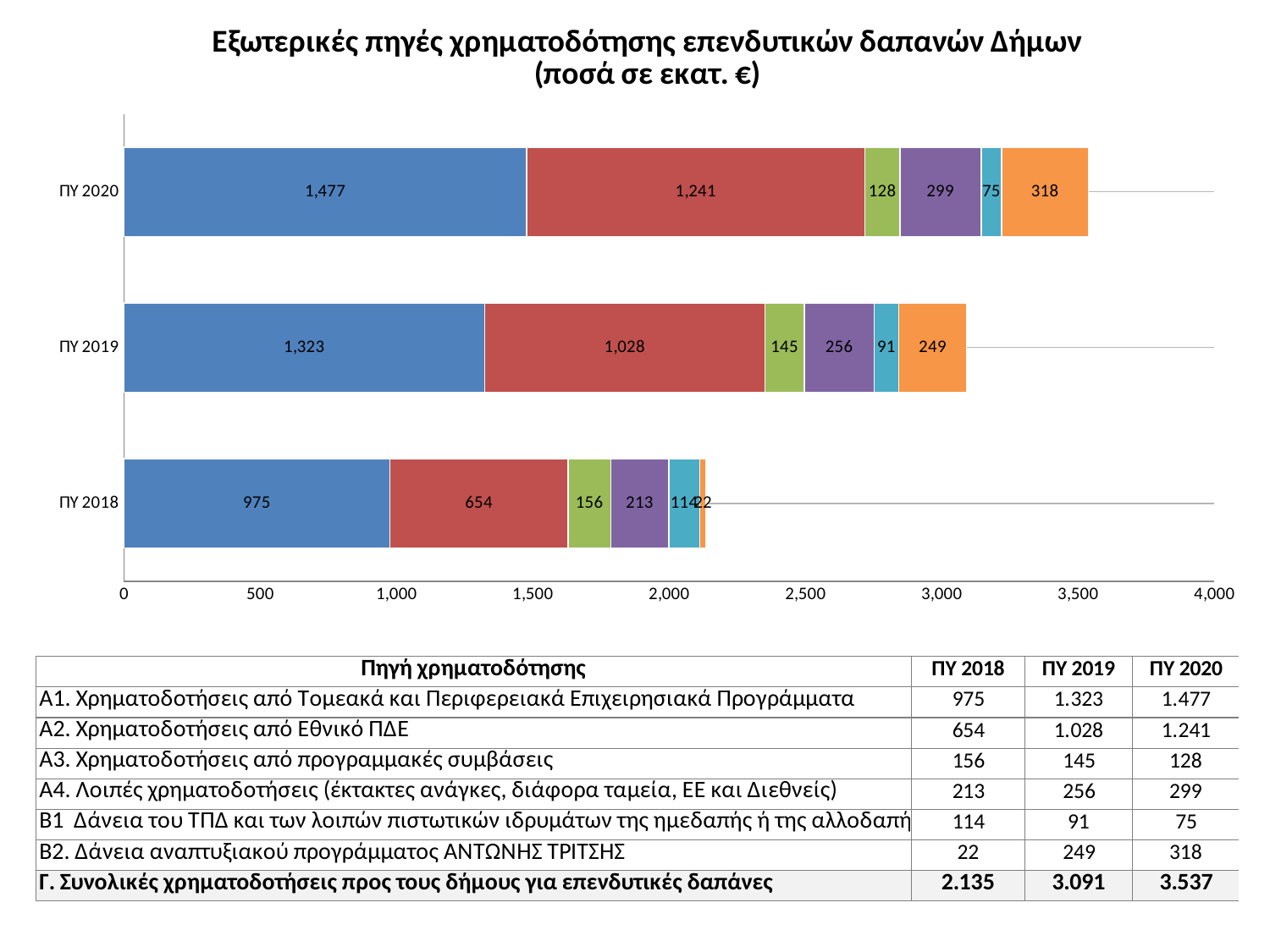
What kind of chart is shown on the slide? Stacked bar chart What is the value of the orange segment of the ΠΥ 2020 bar? 318 What is the value of the second (red) segment of the ΠΥ 2019 bar? 1,028 What is the value of the purple segment of the ΠΥ 2018 bar? 213 Does the value of the first (blue) segment rise or fall from ΠΥ 2018 to ΠΥ 2020? rise Which year has the shortest total bar? ΠΥ 2018 What is the value of the first (blue) segment of the ΠΥ 2020 bar? 1,477 Which year has the longest total bar? ΠΥ 2020 How many categories (years) are plotted on the chart? 3 Is the total length of the ΠΥ 2019 bar greater or less than 3,000? greater Is the green segment larger for ΠΥ 2018 or for ΠΥ 2020? ΠΥ 2018 What is the difference between the blue segment of ΠΥ 2020 (1,477) and the blue segment of ΠΥ 2019 (1,323)? 154